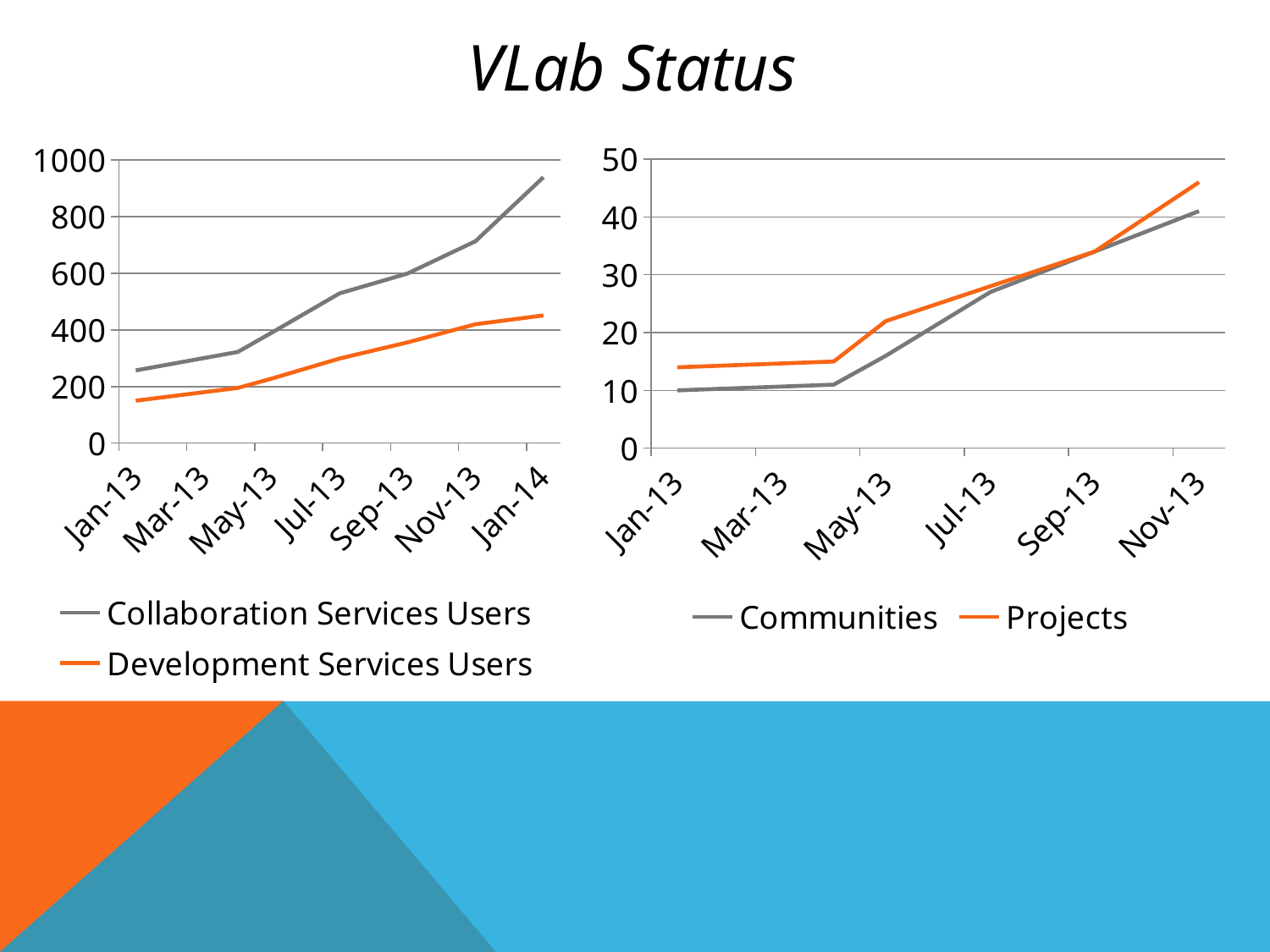
In the right chart, is the value for Projects at Nov-13 greater or less than 40? greater How many series does the legend of the left chart list? 2 In the right chart, which series has the larger value at Jan-13, Communities or Projects? Projects In the left chart, do the Collaboration Services Users values rise or fall from Jan-13 to Jan-14? rise In the right chart, do the Projects values rise or fall from Jan-13 to Nov-13? rise In the left chart, is the value for Development Services Users at Jan-13 greater or less than 200? less What is the title of the slide containing the two charts? VLab Status How many series does the legend of the right chart list? 2 In the right chart, is the value for Communities at Jan-13 greater or less than 20? less In the left chart, which series has the larger value at Jan-14, Collaboration Services Users or Development Services Users? Collaboration Services Users What kind of chart is the left chart on the slide? line chart